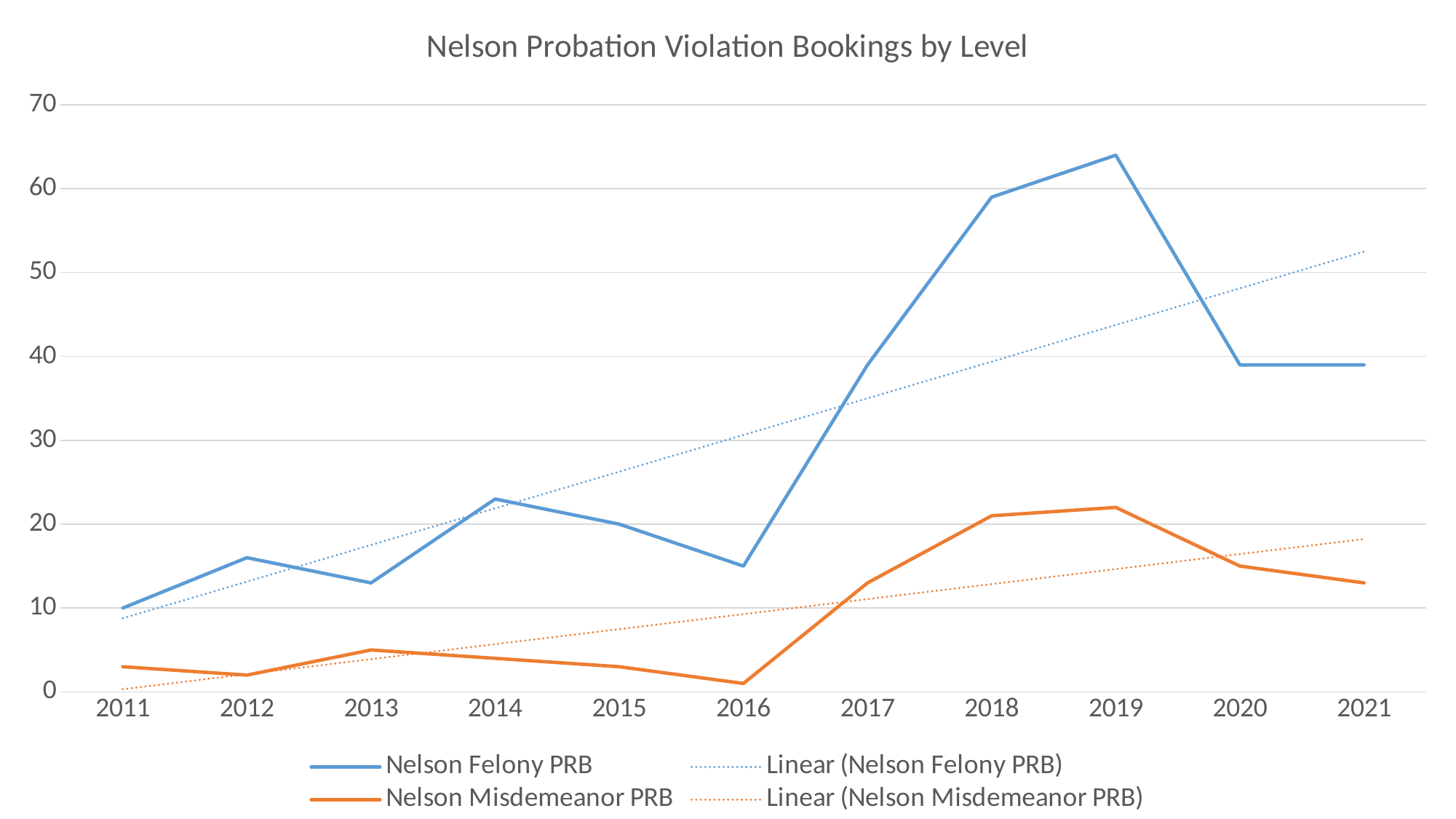
Does the Nelson Felony PRB line rise or fall from 2016 to 2019? rise How many years are shown on the x axis? 11 In which year is the Nelson Misdemeanor PRB value lowest? 2016 In which year is the Nelson Misdemeanor PRB value highest? 2019 What is the Nelson Felony PRB value in 2011? 10 What kind of chart is shown on the slide? line chart How many entries does the legend list? 4 Is the Nelson Felony PRB value for 2019 greater or less than 60? greater Which series has the larger value in 2018, Nelson Felony PRB or Nelson Misdemeanor PRB? Nelson Felony PRB What is the title of the chart? Nelson Probation Violation Bookings by Level Is the Nelson Misdemeanor PRB value for 2013 greater or less than 10? less In which year is the Nelson Felony PRB value highest? 2019